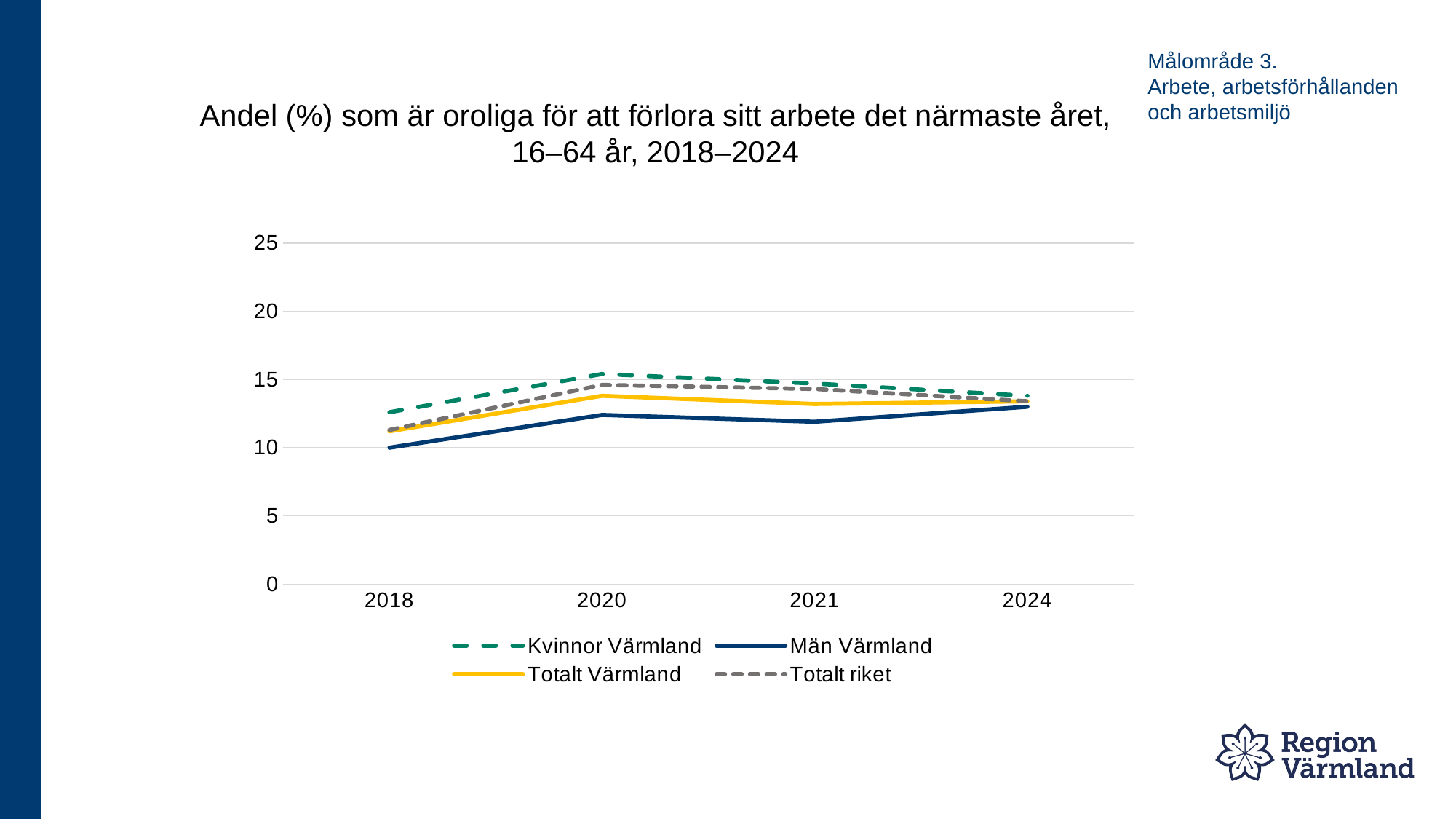
How many years are plotted along the x axis? 4 How many series does the legend list? 4 Is the value for Kvinnor Värmland in 2018 greater or less than 15? less Which series is drawn as a dashed green line? Kvinnor Värmland Which series has the lowest value in 2018? Män Värmland Does the Kvinnor Värmland line rise or fall from 2020 to 2024? fall Is the value for Totalt riket in 2021 greater or less than 10? greater Is the value for Män Värmland in 2020 greater or less than 15? less What kind of chart is shown on the slide? Line chart In 2018, which is larger: Kvinnor Värmland or Män Värmland? Kvinnor Värmland Which series has the highest value in 2020? Kvinnor Värmland Does the Män Värmland line rise or fall from 2018 to 2020? rise